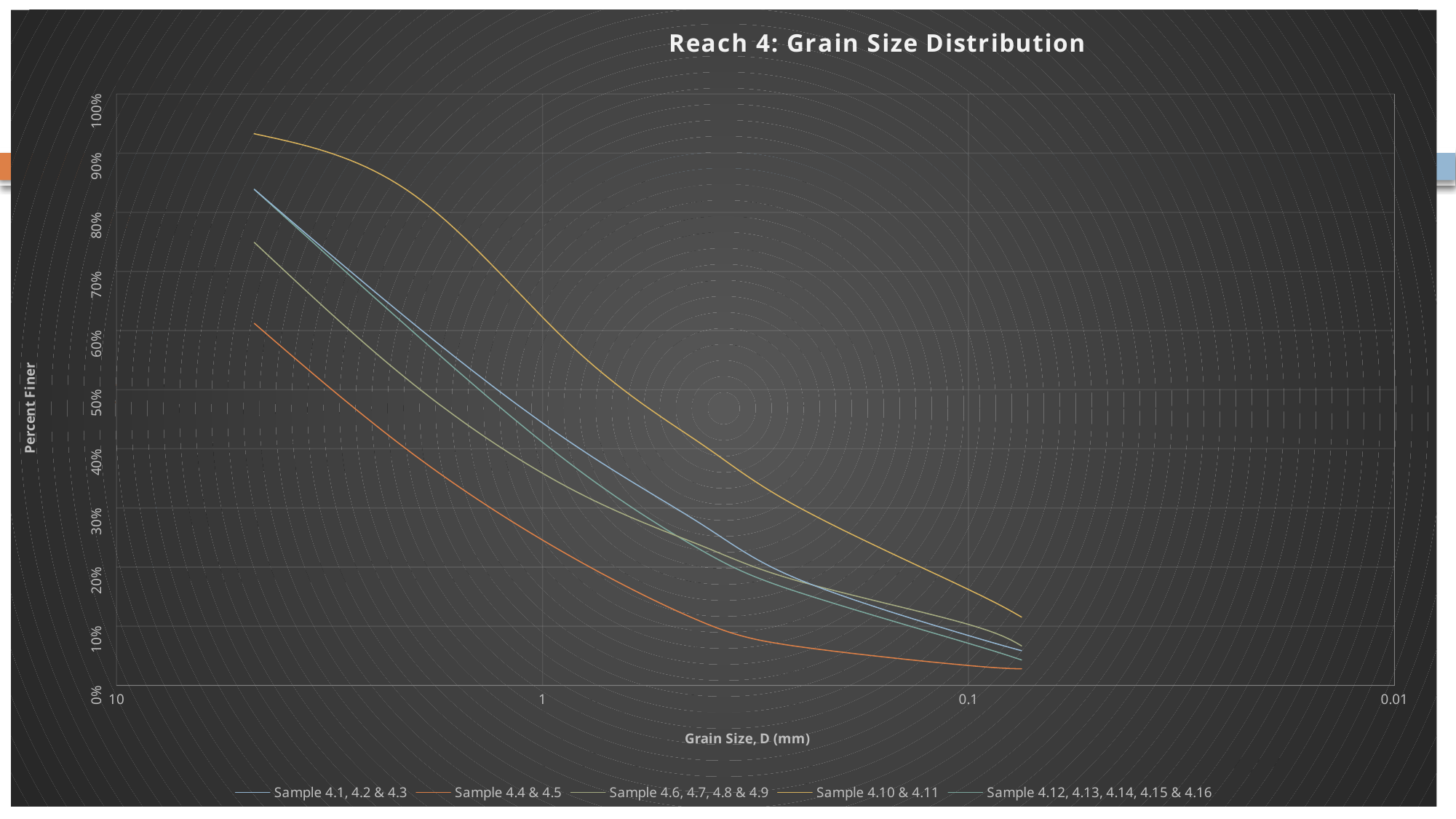
At a grain size of 1 mm, which series has the larger Percent Finer: Sample 4.10 & 4.11 or Sample 4.4 & 4.5? Sample 4.10 & 4.11 What is the title of the chart? Reach 4: Grain Size Distribution What kind of chart is shown on the slide? Line chart What is the label of the vertical axis? Percent Finer Do the Percent Finer values rise or fall as you move from left to right along the Grain Size axis? Fall How many series does the legend list? 5 Which series has the highest Percent Finer at a grain size of 1 mm? Sample 4.10 & 4.11 Is the Percent Finer for Sample 4.10 & 4.11 at a grain size of 1 mm greater or less than 50%? greater Is the highest Percent Finer value reached by Sample 4.10 & 4.11 greater or less than 90%? greater Which series has the lowest Percent Finer at a grain size of 1 mm? Sample 4.4 & 4.5 Is the Percent Finer for Sample 4.4 & 4.5 at a grain size of 0.1 mm greater or less than 10%? less